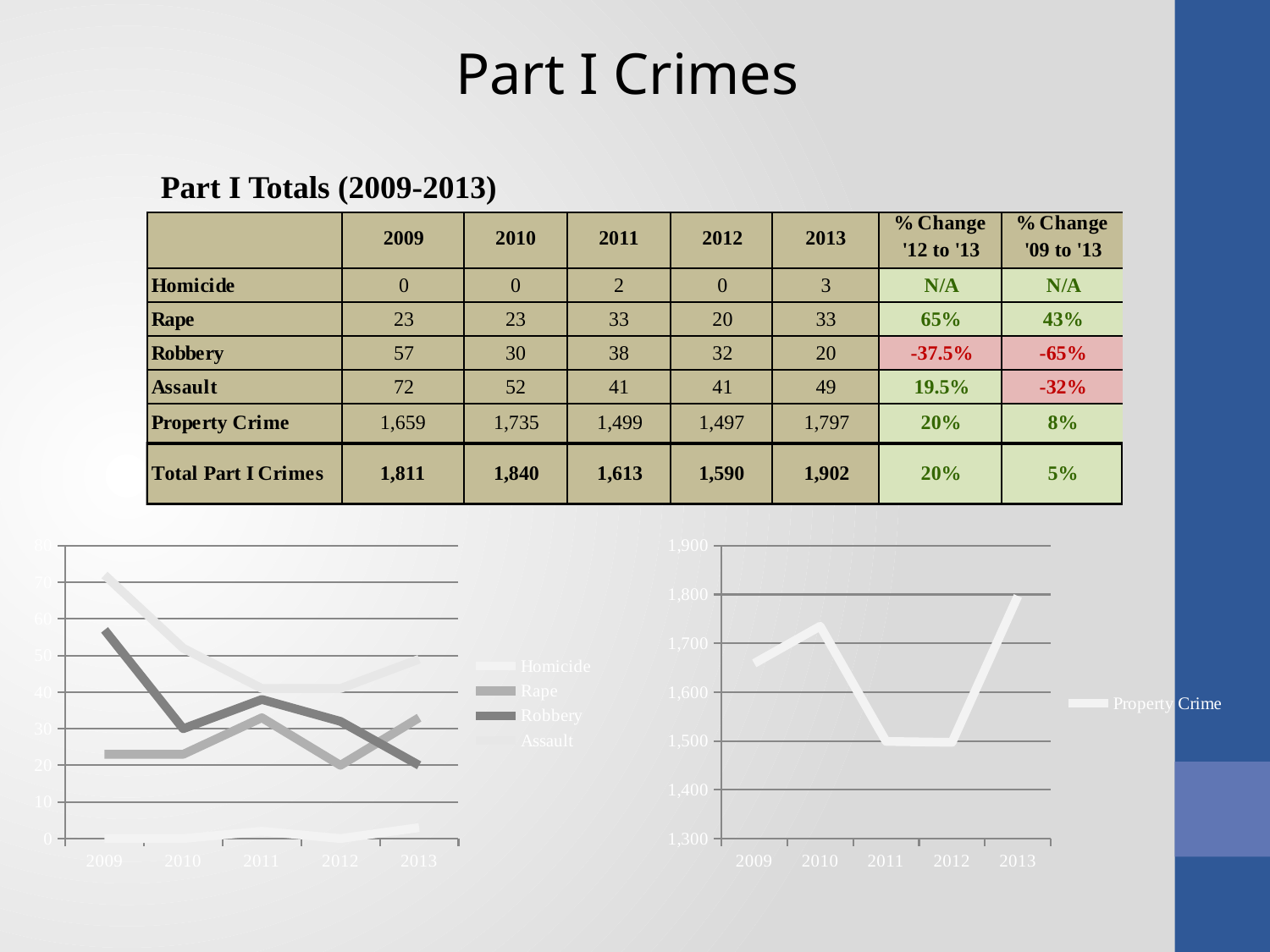
In the right chart, is the Property Crime value for 2013 greater or less than 1,700? greater How many years are plotted along the x axis of the right chart? 5 In the left chart, does the Robbery line rise or fall from 2009 to 2013? fall What kind of chart is the chart on the left of the slide? line chart In the left chart, is the Assault value for 2009 greater or less than 60? greater In the left chart, which is larger in 2013, Rape or Robbery? Rape In the right chart, is the Property Crime value for 2012 greater or less than 1,600? less Which series does the legend of the right chart list? Property Crime In the right chart, which year has the highest Property Crime value? 2013 In the left chart, which series has the lowest value in 2013? Homicide How many series does the legend of the left chart list? 4 In the left chart, which series has the highest value in 2009? Assault